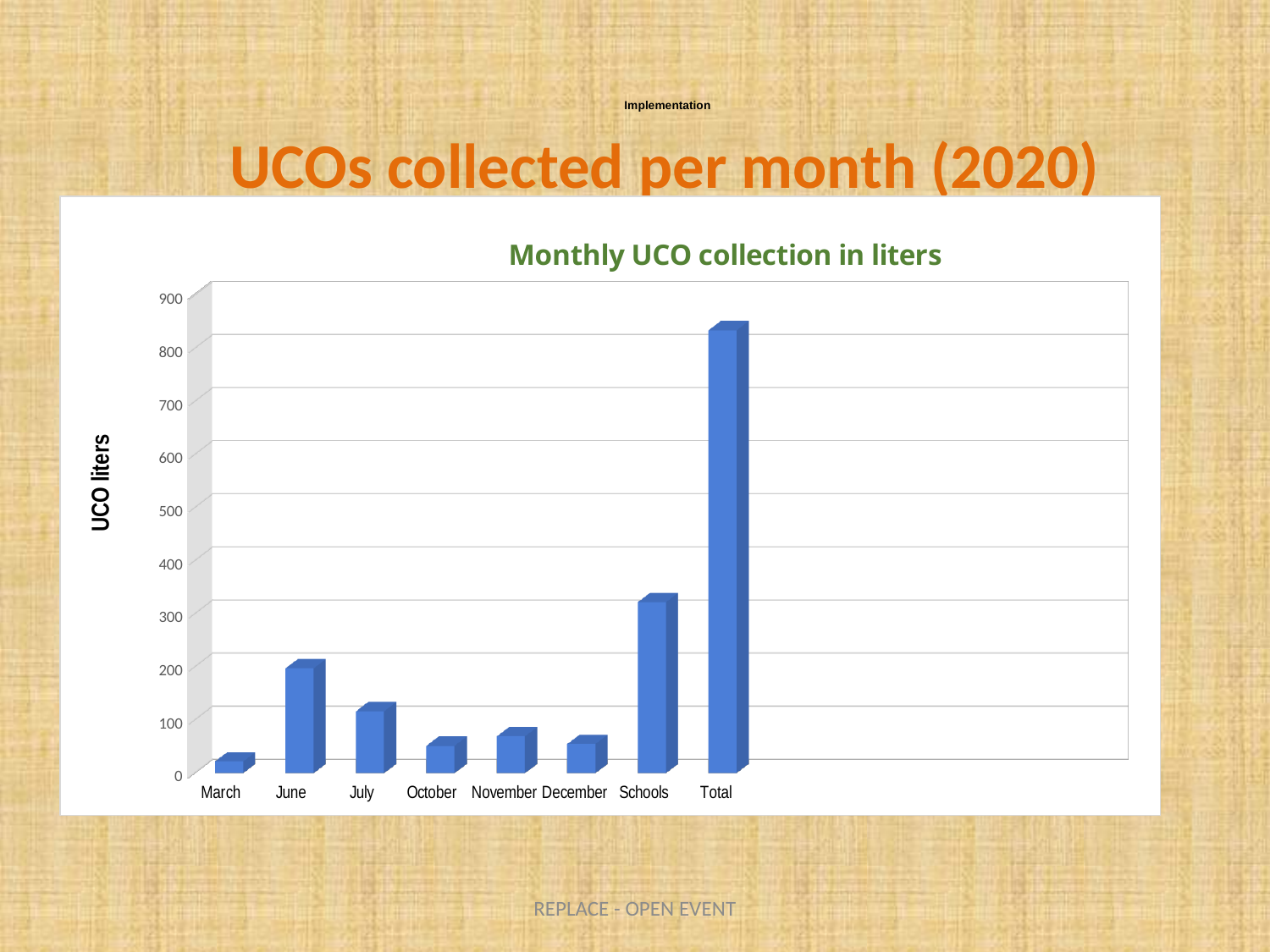
What is the title of the chart? Monthly UCO collection in liters Is the value for Total greater or less than 700? greater Which category has the highest value in the chart? Total Which is larger, the value for November or the value for October? November Which is larger, the value for June or the value for July? June Which category has the lowest value in the chart? March What kind of chart is shown on the slide? bar chart Is the value for March greater or less than 100? less Which is larger, the value for Schools or the value for June? Schools Is the value for June greater or less than 300? less How many categories are shown on the x axis of the chart? 8